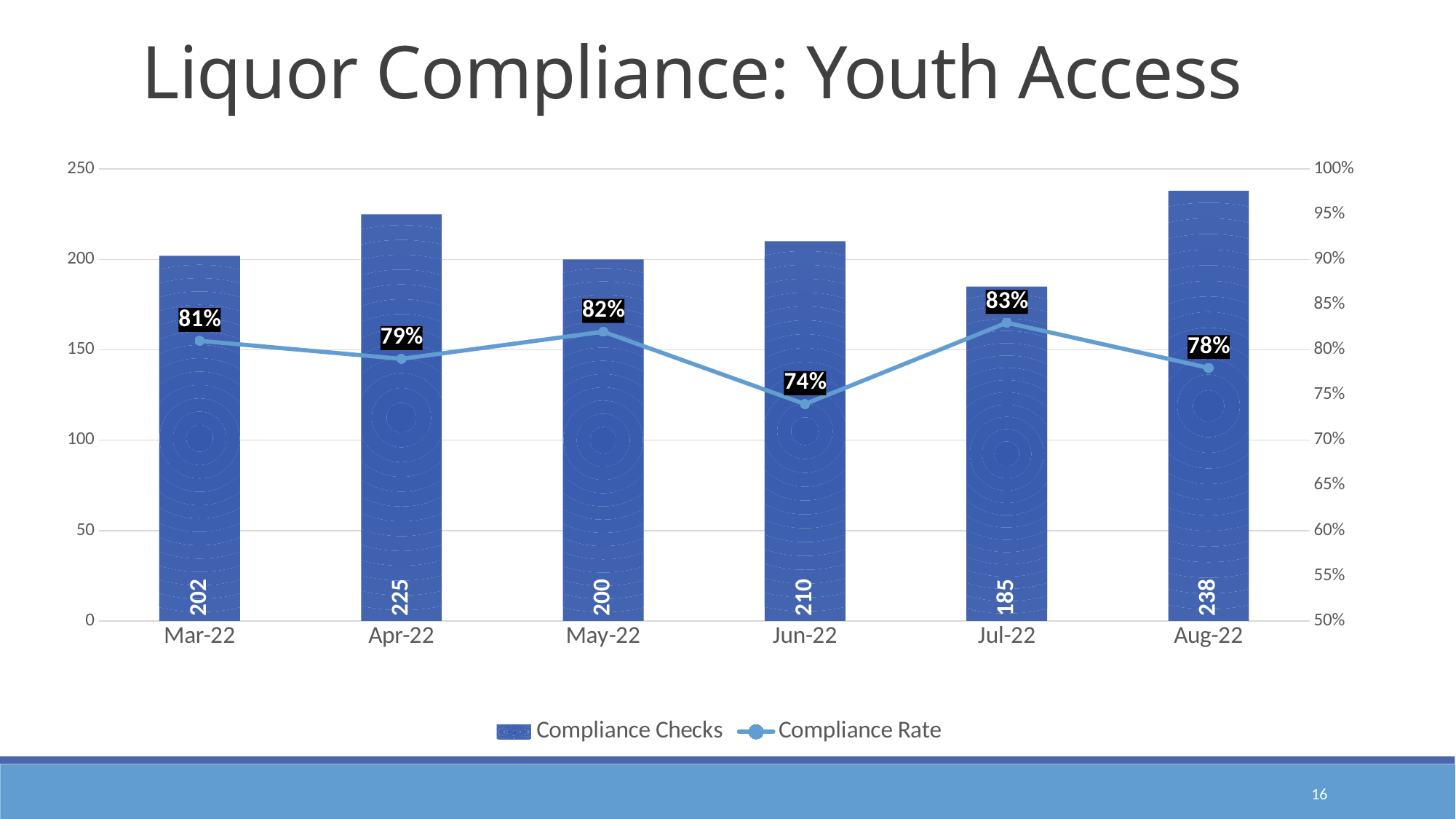
Which month had the higher Compliance Rate, Jul-22 or Aug-22? Jul-22 How many months are shown on the x axis? 6 What kind of chart is used to show the Compliance Checks series? bar chart Which month had the lowest number of Compliance Checks? Jul-22 What is the difference in Compliance Checks between Aug-22 and Jul-22? 53 Is the number of Compliance Checks in Mar-22 greater or less than 200? greater What was the Compliance Rate in Jun-22? 74% What is the title of the slide? Liquor Compliance: Youth Access How many series does the legend list? 2 Which month had the highest number of Compliance Checks? Aug-22 Which month had the lowest Compliance Rate? Jun-22 How many Compliance Checks were there in Apr-22? 225